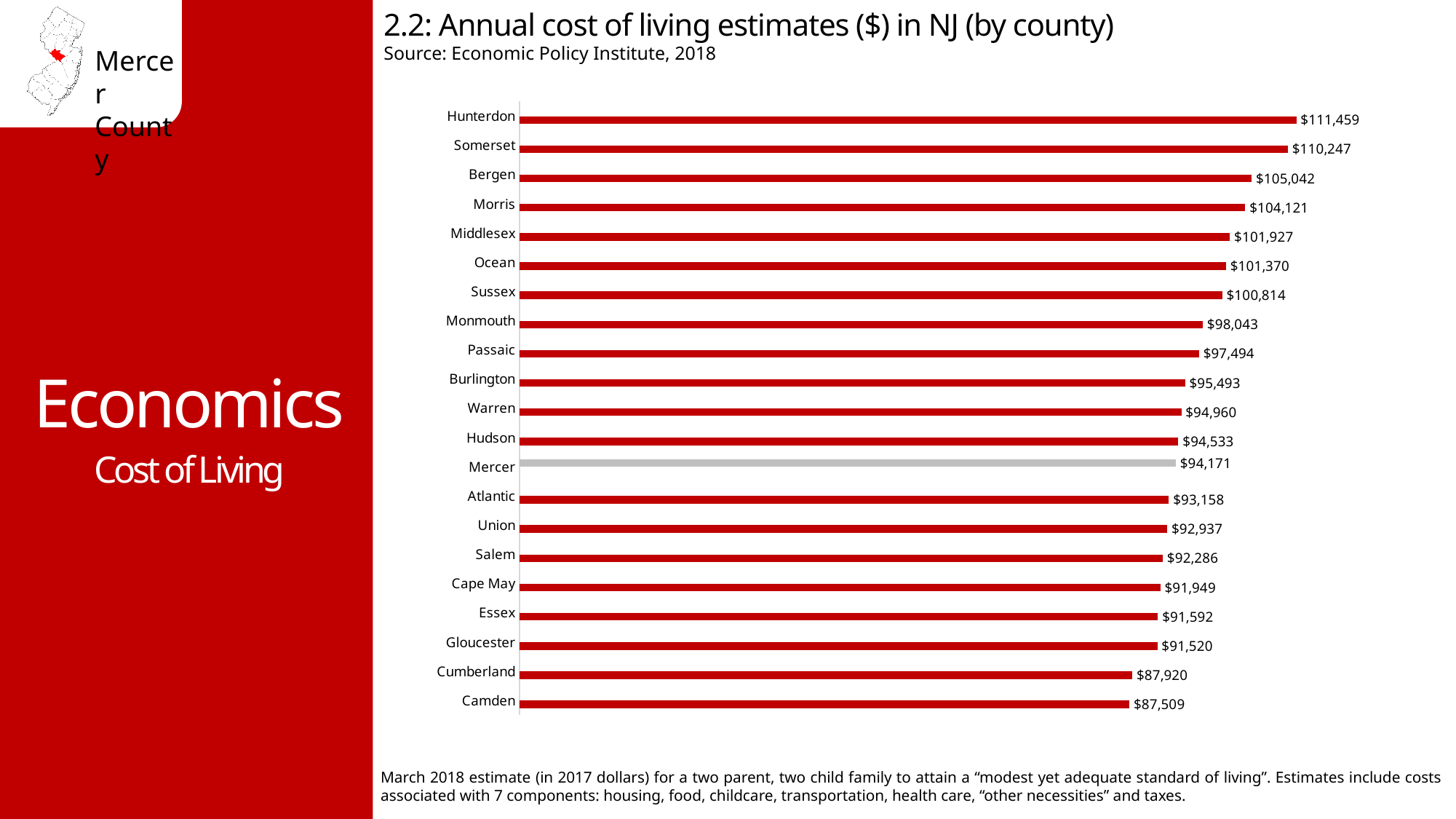
How many counties are shown in the chart? 21 Which county has the highest annual cost of living estimate? Hunterdon What is the difference between the cost of living estimates for Hudson and Mercer? $362 What is the annual cost of living estimate for Bergen County? $105,042 What is the source cited for the chart data? Economic Policy Institute, 2018 Which county's bar is shown in grey instead of red? Mercer What kind of chart is used to show the cost of living estimates? Bar chart What is the difference between the cost of living estimates for Hunterdon and Camden? $23,950 Which county has the lowest annual cost of living estimate? Camden What is the annual cost of living estimate for Cumberland County? $87,920 What is the annual cost of living estimate for Mercer County? $94,171 Which county has a higher cost of living estimate, Morris or Monmouth? Morris